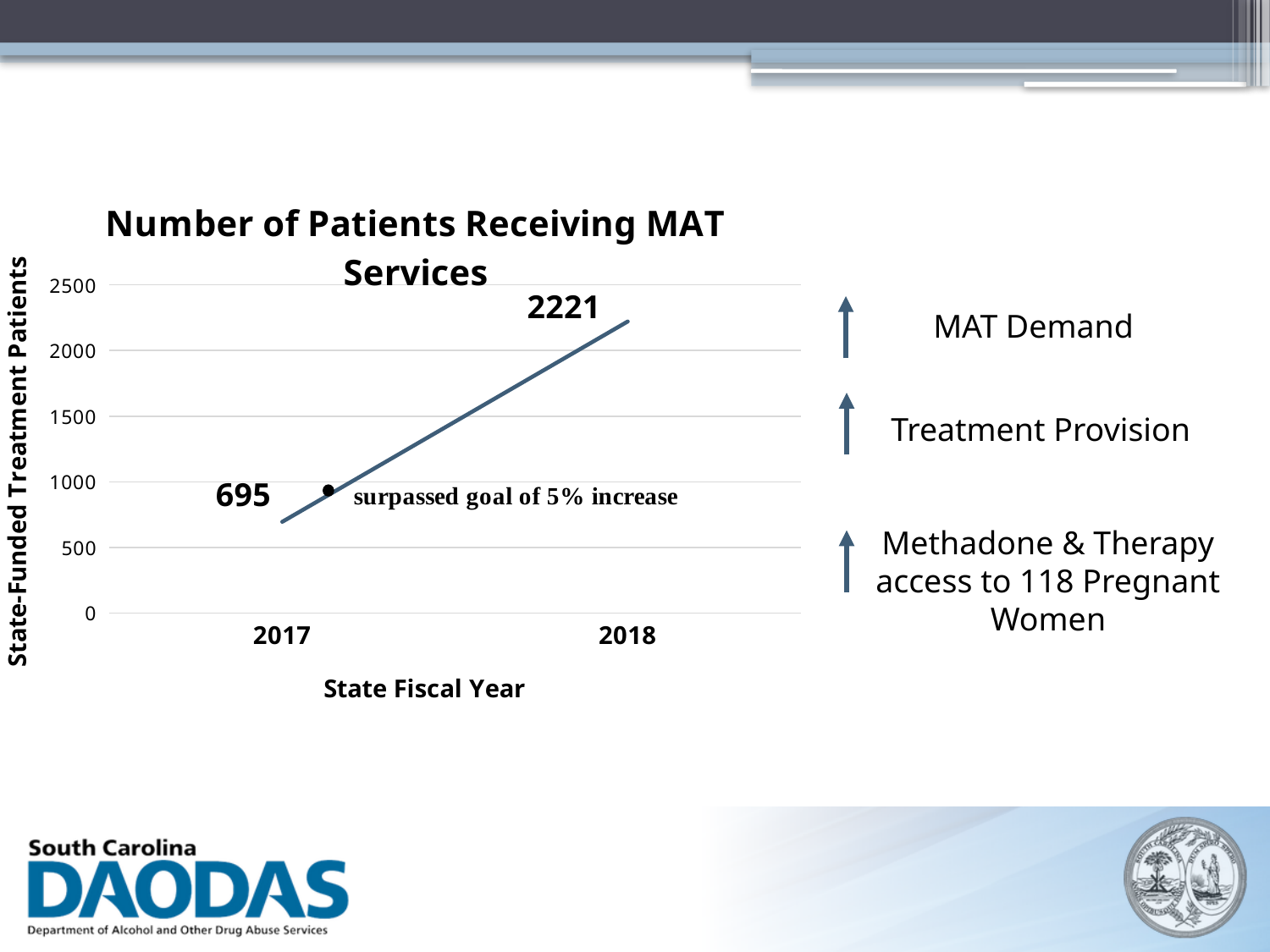
Which fiscal year has the lower number of patients receiving MAT services? 2017 What is the difference between the number of patients in 2018 and in 2017? 1526 What is the title of the chart? Number of Patients Receiving MAT Services How many fiscal years are plotted on the chart? 2 Which fiscal year has the higher number of patients receiving MAT services? 2018 What is the label of the x axis of the chart? State Fiscal Year What is the number of patients receiving MAT services in 2017? 695 What is the number of patients receiving MAT services in 2018? 2221 Do the values rise or fall from 2017 to 2018? rise Is the value for 2018 greater or less than 2000? greater Is the value for 2017 greater or less than 1000? less What kind of chart is shown on the slide? line chart